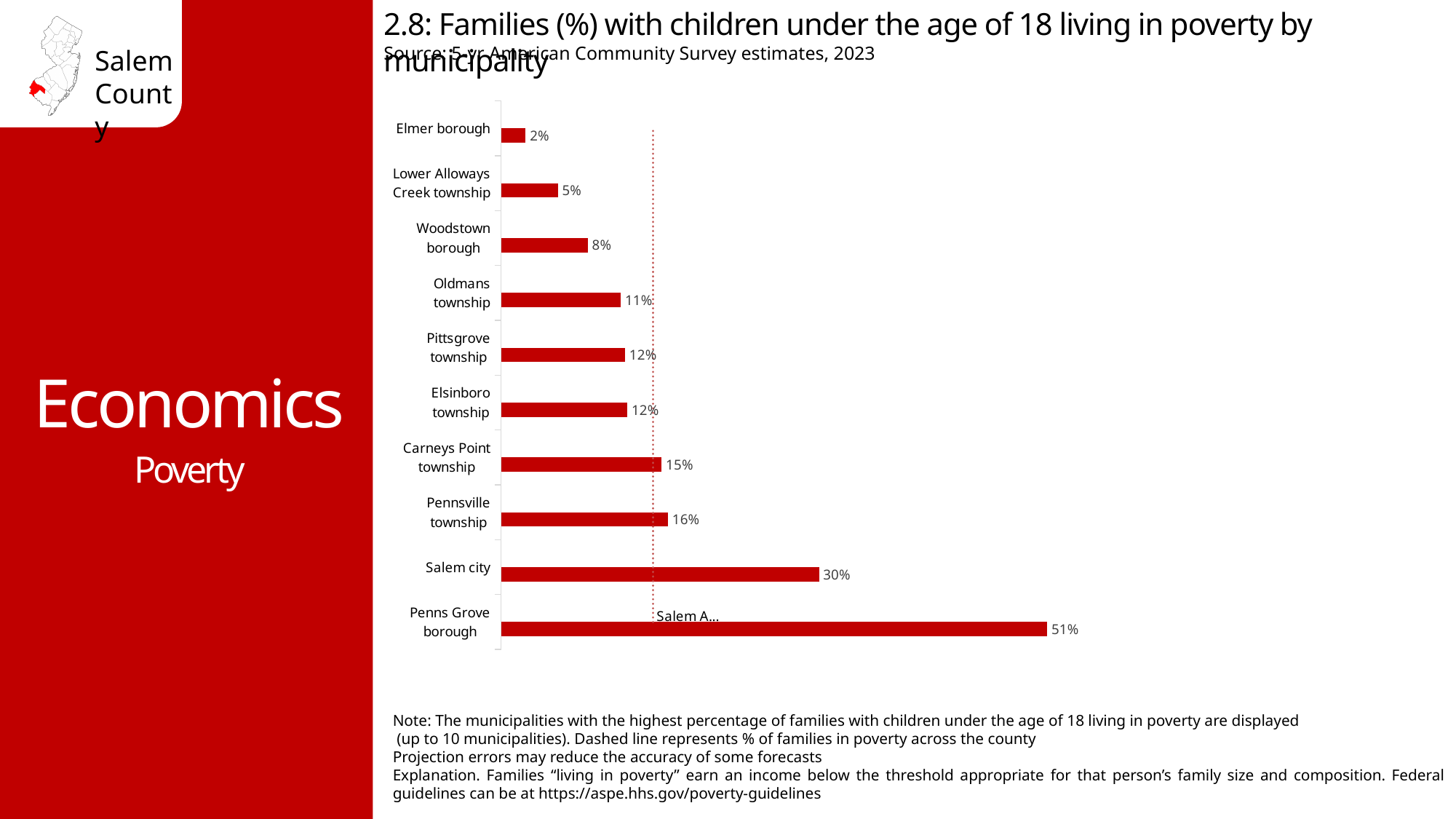
How many municipalities are shown on the chart? 10 What is the difference between the values for Carneys Point township and Woodstown borough? 7% What does the dashed vertical line on the chart represent? % of families in poverty across the county What is the value shown for Salem city? 30% What is the value shown for Elmer borough? 2% Which has a higher value, Pennsville township or Oldmans township? Pennsville township What type of chart is shown on the slide? Bar chart Which municipality has the highest percentage of families with children under 18 living in poverty? Penns Grove borough What is the value shown for Pennsville township? 16% What percentage of families with children under 18 are living in poverty in Penns Grove borough? 51% What is the difference between the values for Penns Grove borough and Salem city? 21% Which municipality has the lowest percentage shown on the chart? Elmer borough